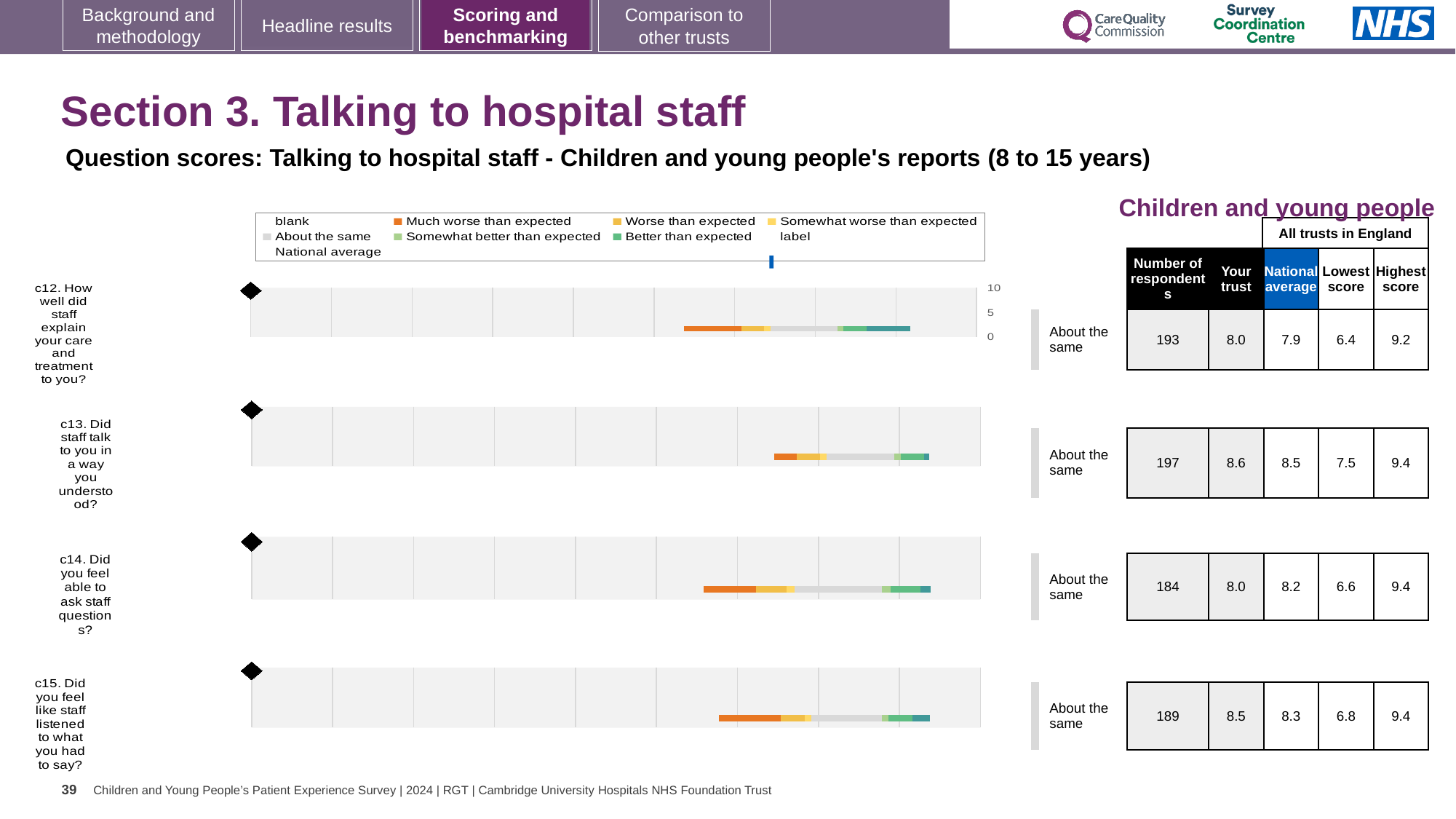
What is the difference between the highest and lowest trust scores in England for c12? 2.8 What is the benchmark label shown for c12 (How well did staff explain your care and treatment to you?)? About the same Which question has the lowest national average score? c12 What is the 'Your trust' score for c13 (Did staff talk to you in a way you understood?)? 8.6 What is the highest score among all trusts in England for c12? 9.2 What is the difference between the 'Your trust' score and the national average for c13? 0.1 What type of chart is used to show the question scores for c12 to c15? bar chart Which question has the highest 'Your trust' score? c13 How many survey questions are plotted in the chart? 4 For c15, which is larger: the 'Your trust' score or the national average? Your trust How many respondents answered c15 (Did you feel like staff listened to what you had to say?)? 189 What is the national average score for c14 (Did you feel able to ask staff questions?)? 8.2